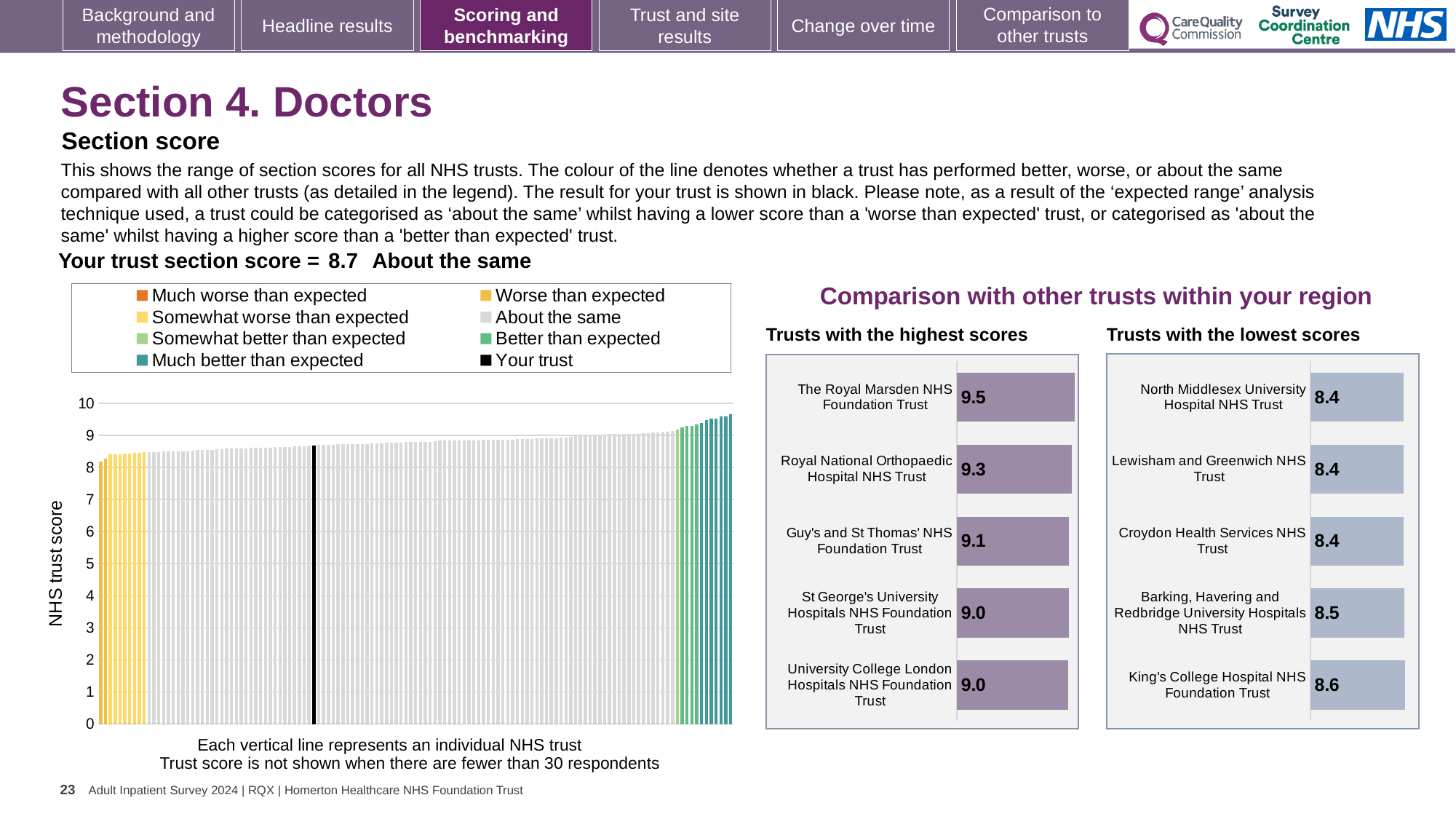
On the left chart, what is the label of the vertical axis? NHS trust score What type of chart is the large chart on the left showing NHS trust scores? Bar chart In the 'Trusts with the highest scores' chart, which trust has the highest score? The Royal Marsden NHS Foundation Trust How many entries does the legend of the left chart list? 8 In the 'Trusts with the lowest scores' chart, what is the score for King's College Hospital NHS Foundation Trust? 8.6 What is your trust's section score shown on the slide? 8.7 In the 'Trusts with the highest scores' chart, what is the difference between the scores of The Royal Marsden NHS Foundation Trust and Guy's and St Thomas' NHS Foundation Trust? 0.4 On the left chart, is the value of the black 'Your trust' bar greater or less than 8? greater In the 'Trusts with the lowest scores' chart, which has the larger score: King's College Hospital NHS Foundation Trust or Barking, Havering and Redbridge University Hospitals NHS Trust? King's College Hospital NHS Foundation Trust In the 'Trusts with the highest scores' chart, what is the score for The Royal Marsden NHS Foundation Trust? 9.5 On the left chart, is the value of the tallest bar greater or less than 10? less How many trusts are shown in the 'Trusts with the lowest scores' chart? 5